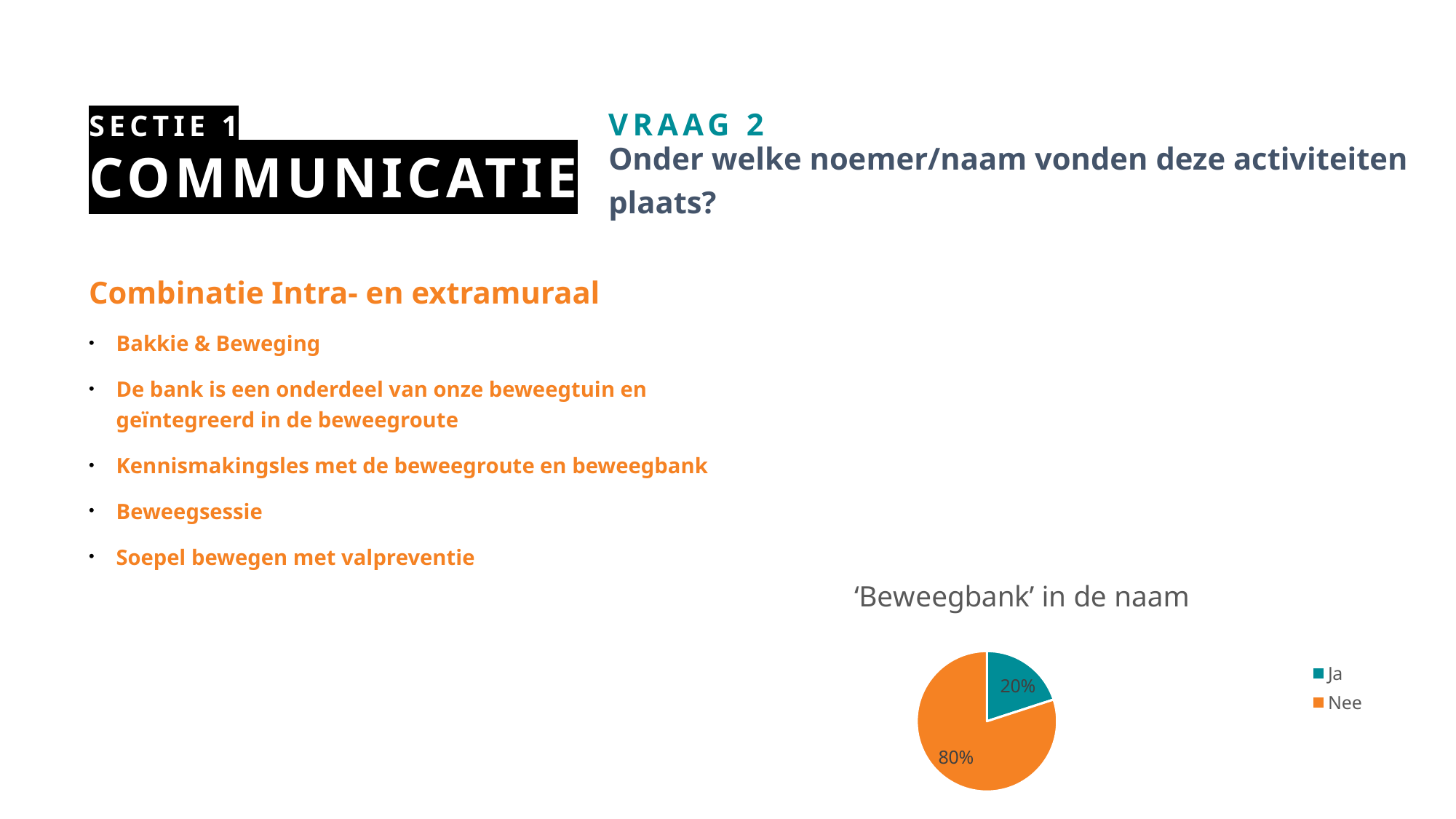
What is the difference in percentage points between the 'Nee' and 'Ja' slices? 60 What kind of chart is shown on the slide? pie chart What is the title of the pie chart? ‘Beweegbank’ in de naam Which is larger in the pie chart, 'Ja' or 'Nee'? Nee How many slices does the pie chart have? 2 What colour is the 'Nee' slice in the pie chart? orange What share of the pie does 'Ja' represent? 20% Which slice of the pie chart is the smallest? Ja Which slice of the pie chart is the largest? Nee What share of the pie does 'Nee' represent? 80% How many entries does the legend of the pie chart list? 2